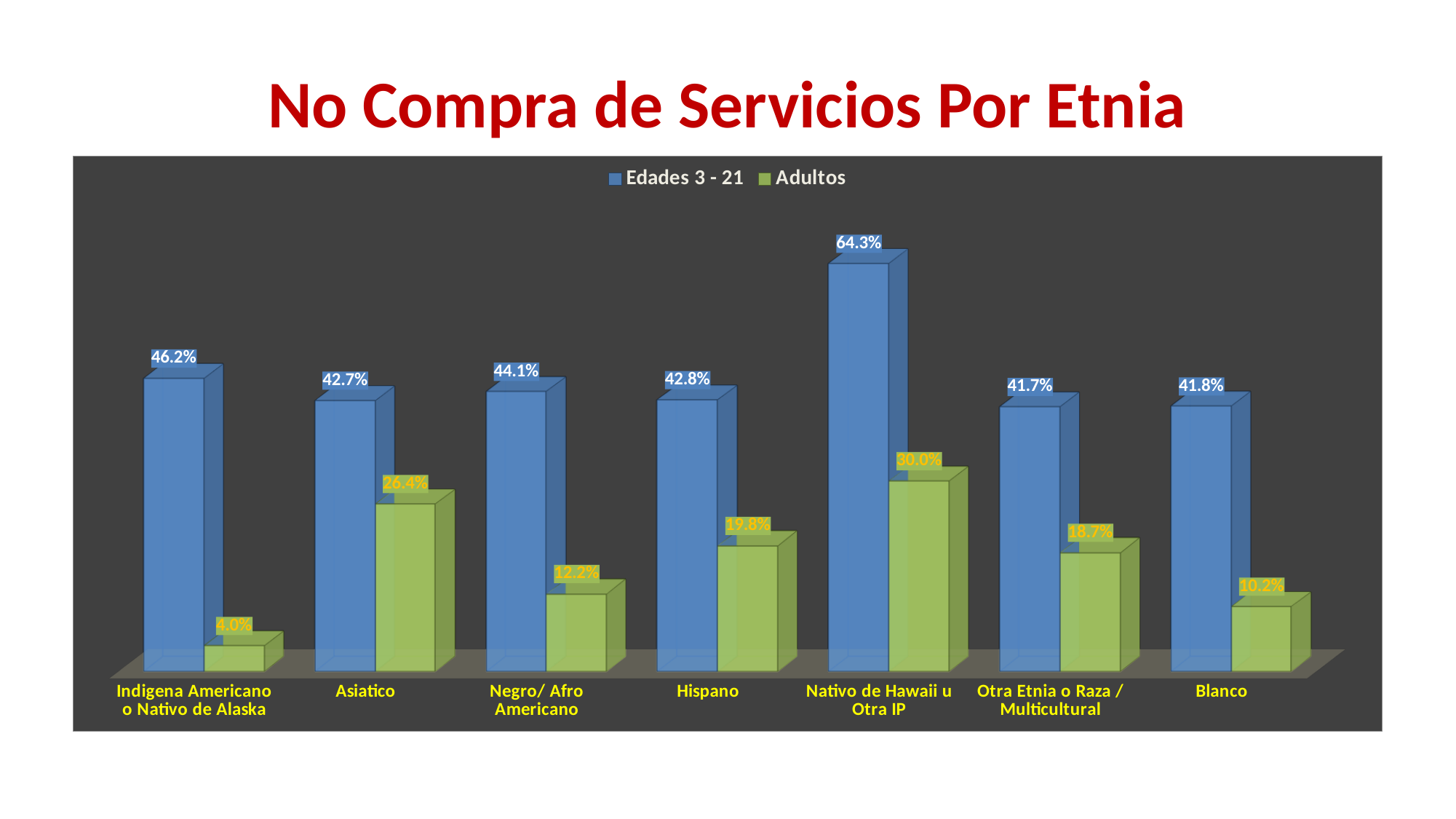
Which is larger, the Adultos value for Hispano or the Adultos value for Otra Etnia o Raza / Multicultural? Hispano What kind of chart is shown on the slide? Bar chart What is the title of the slide? No Compra de Servicios Por Etnia Which category has the lowest value for Adultos? Indigena Americano o Nativo de Alaska What is the value for Adultos for Indigena Americano o Nativo de Alaska? 4.0% What is the difference between the Edades 3 - 21 and Adultos values for Blanco? 31.6% How many categories are shown on the x axis? 7 What is the value for Edades 3 - 21 for Nativo de Hawaii u Otra IP? 64.3% Which category has the highest value for Edades 3 - 21? Nativo de Hawaii u Otra IP Which colour represents the Adultos series? Green What is the value for Adultos for Asiatico? 26.4% How many series does the legend list? 2